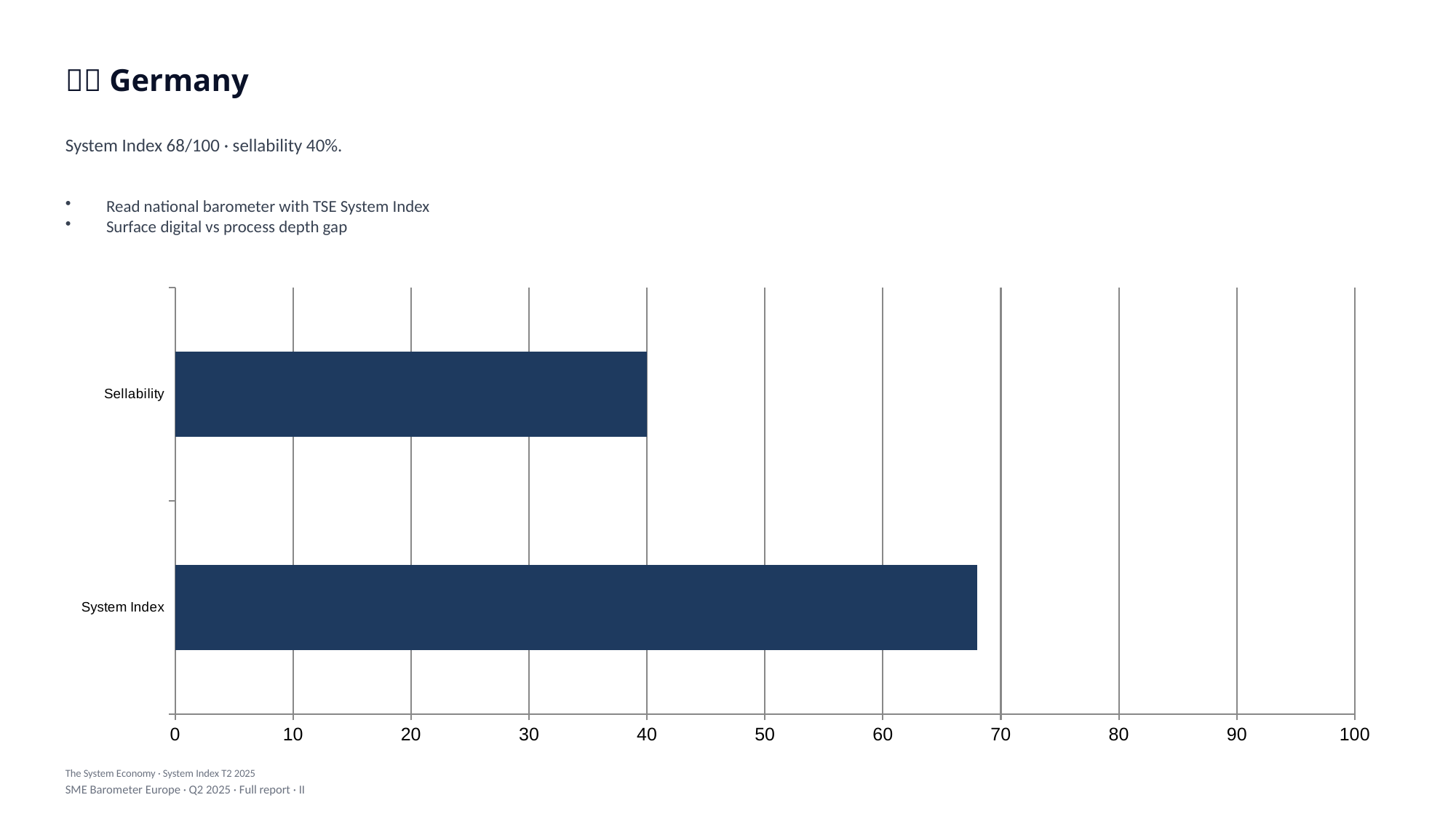
Which country is named in the slide title? Germany Which category has the lowest value? Sellability What is the value of the System Index bar? 68 How many categories does the bar chart show? 2 What is the difference between the System Index value and the Sellability value? 28 Which category has the highest value? System Index What kind of chart is shown on the slide? bar chart What is the value of the Sellability bar? 40 Is the value for Sellability greater or less than 50? less Which is larger, the System Index bar or the Sellability bar? System Index What is the maximum value shown on the horizontal axis? 100 Is the value for System Index greater or less than 60? greater